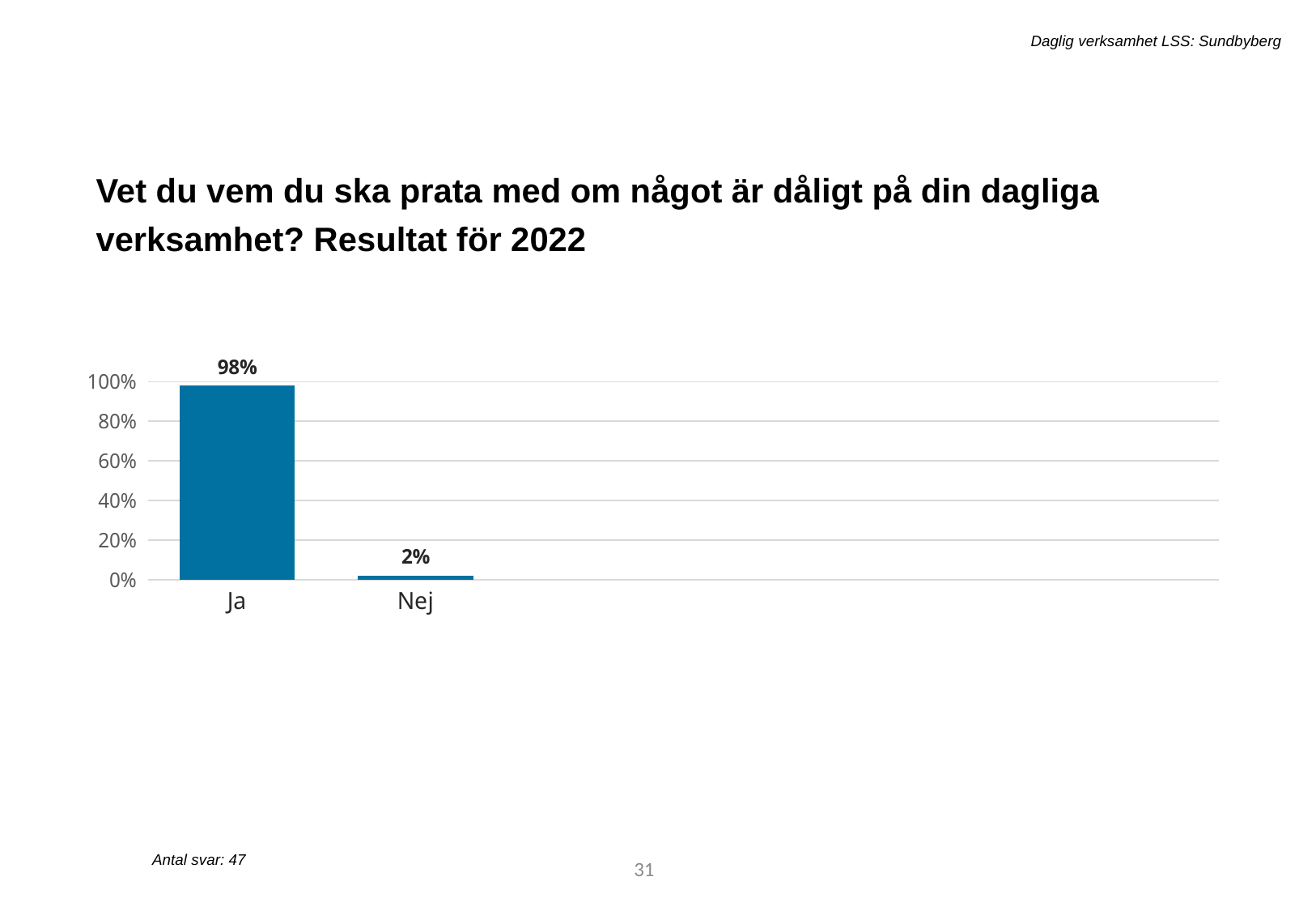
What is the value for Nej? 2% Is the value for Nej greater or less than 20%? less Which category has the highest value? Ja What kind of chart is shown on the slide? bar chart What is the value for Ja? 98% How many categories are shown on the x axis? 2 How many responses (Antal svar) does the slide report? 47 Which category has the lowest value? Nej Is the value for Ja greater or less than 80%? greater What is the difference between the values for Ja and Nej? 96% What is the total of the values for Ja and Nej? 100% Which is larger, the value for Ja or the value for Nej? Ja